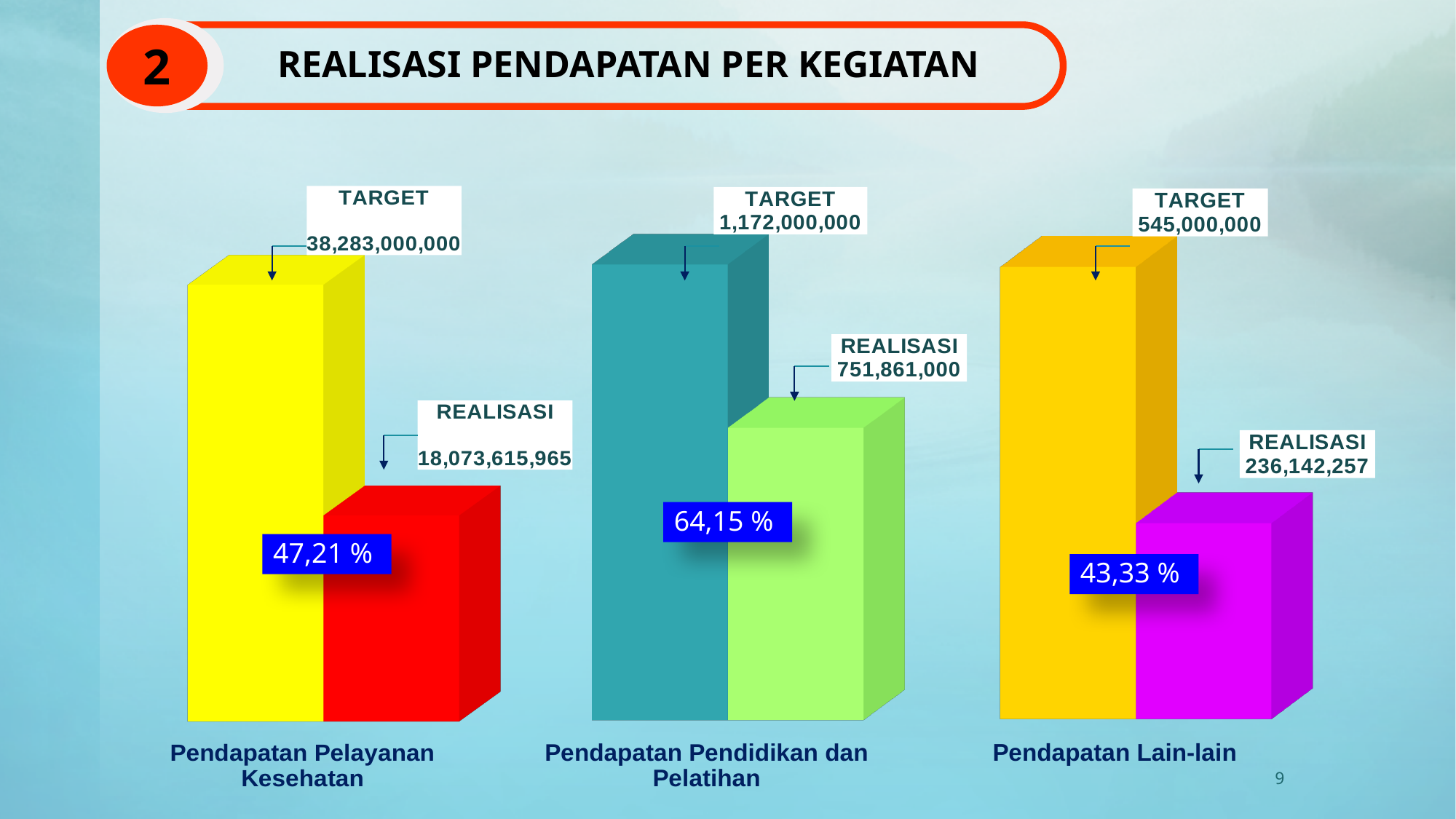
What is the title of the chart? REALISASI PENDAPATAN PER KEGIATAN What is the REALISASI value for Pendapatan Pendidikan dan Pelatihan? 751,861,000 What percentage is shown for Pendapatan Lain-lain? 43,33 % Which is larger, the REALISASI for Pendapatan Pelayanan Kesehatan or the TARGET for Pendapatan Pendidikan dan Pelatihan? REALISASI for Pendapatan Pelayanan Kesehatan What is the difference between TARGET and REALISASI for Pendapatan Pendidikan dan Pelatihan? 420,139,000 Which category has the highest realisation percentage? Pendapatan Pendidikan dan Pelatihan How many categories are shown on the chart? 3 What is the TARGET value for Pendapatan Pelayanan Kesehatan? 38,283,000,000 Which category has the lowest realisation percentage? Pendapatan Lain-lain What is the TARGET value for Pendapatan Lain-lain? 545,000,000 What is the difference between TARGET and REALISASI for Pendapatan Lain-lain? 308,857,743 What percentage is shown for Pendapatan Pendidikan dan Pelatihan? 64,15 %